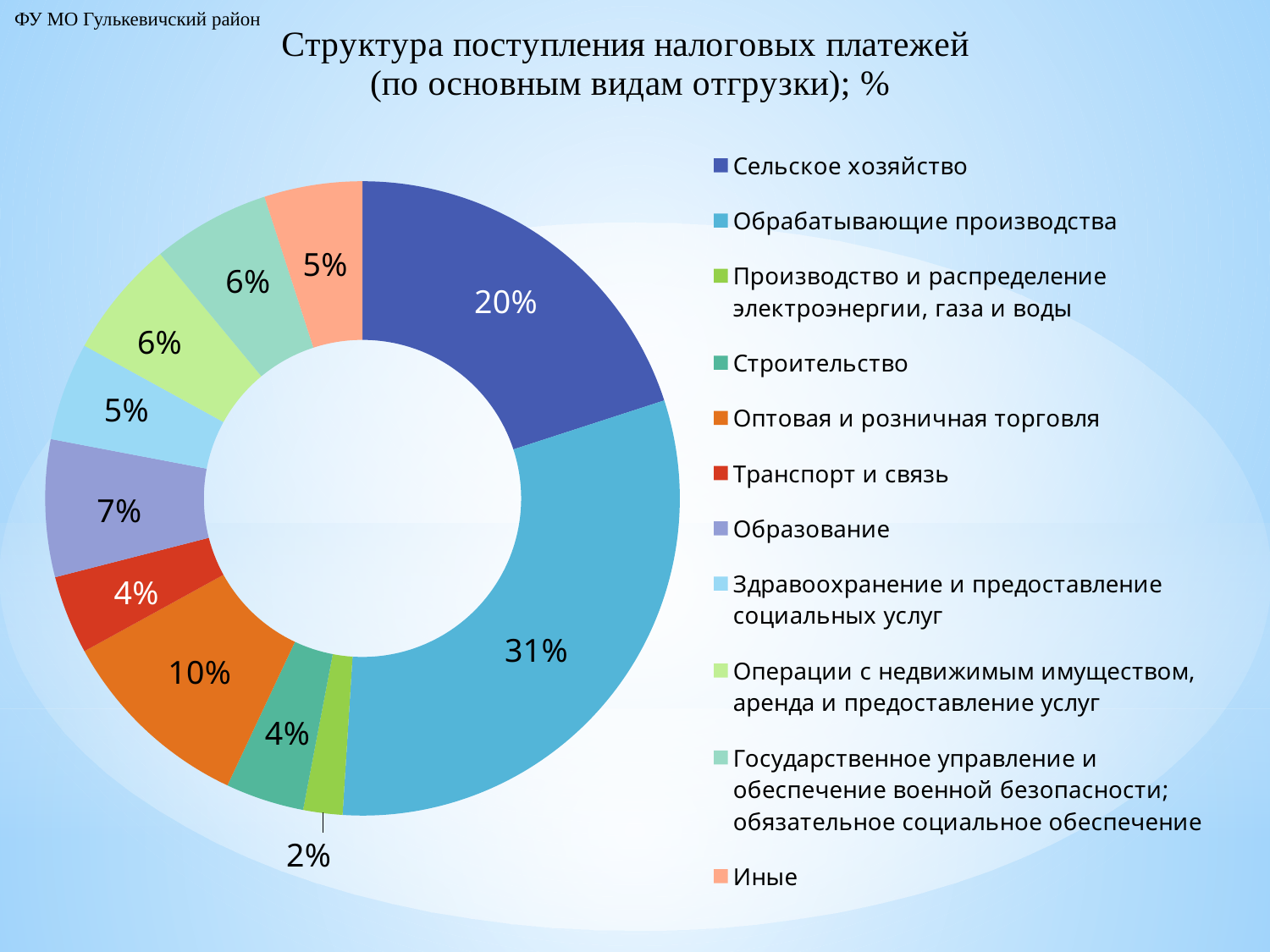
Which category has the largest share of tax payments? Обрабатывающие производства How many categories does the legend list? 11 What is the combined share of Сельское хозяйство and Обрабатывающие производства? 51% What share is shown for Образование? 7% What share is shown for Производство и распределение электроэнергии, газа и воды? 2% Which category has the smallest share of tax payments? Производство и распределение электроэнергии, газа и воды What share of tax payments comes from Обрабатывающие производства? 31% What kind of chart is shown on the slide? Doughnut (pie) chart What share is shown for Оптовая и розничная торговля? 10% What share of tax payments comes from Сельское хозяйство? 20% What is the difference between the shares of Обрабатывающие производства and Сельское хозяйство? 11 percentage points Which has a larger share: Оптовая и розничная торговля or Образование? Оптовая и розничная торговля